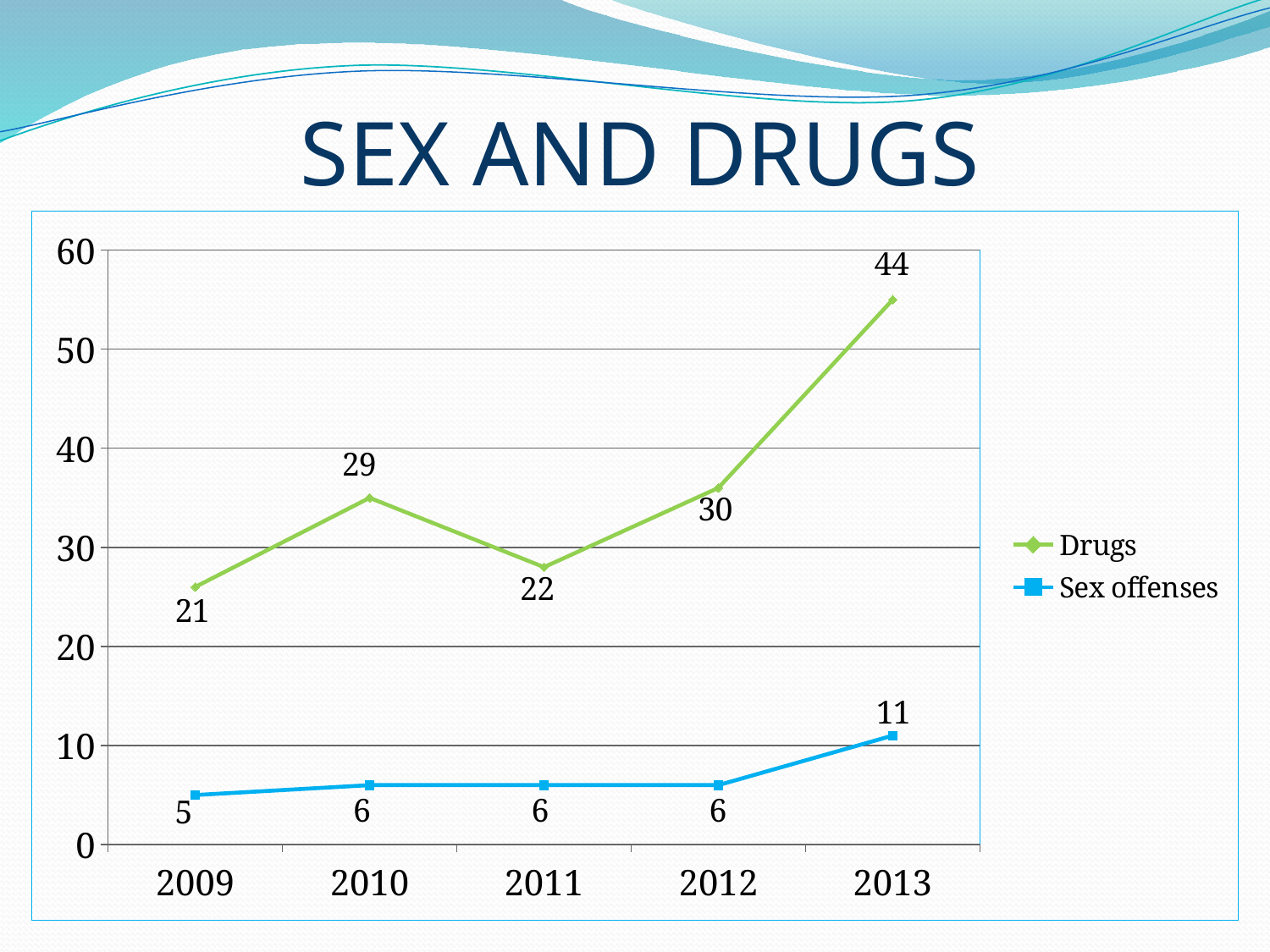
How many years are shown on the x axis? 5 What kind of chart is shown on the slide? Line chart Which is larger in 2010, the Drugs value or the Sex offenses value? Drugs What is the value for Drugs in 2011? 22 Does the Sex offenses value rise or fall from 2012 to 2013? Rise What is the value for Sex offenses in 2009? 5 What is the title of the slide? SEX AND DRUGS What is the value for Drugs in 2013? 44 How many series does the legend list? 2 What is the difference between the Drugs values in 2013 and 2012? 14 In which year is the Drugs value lowest? 2009 In which year is the Drugs value highest? 2013